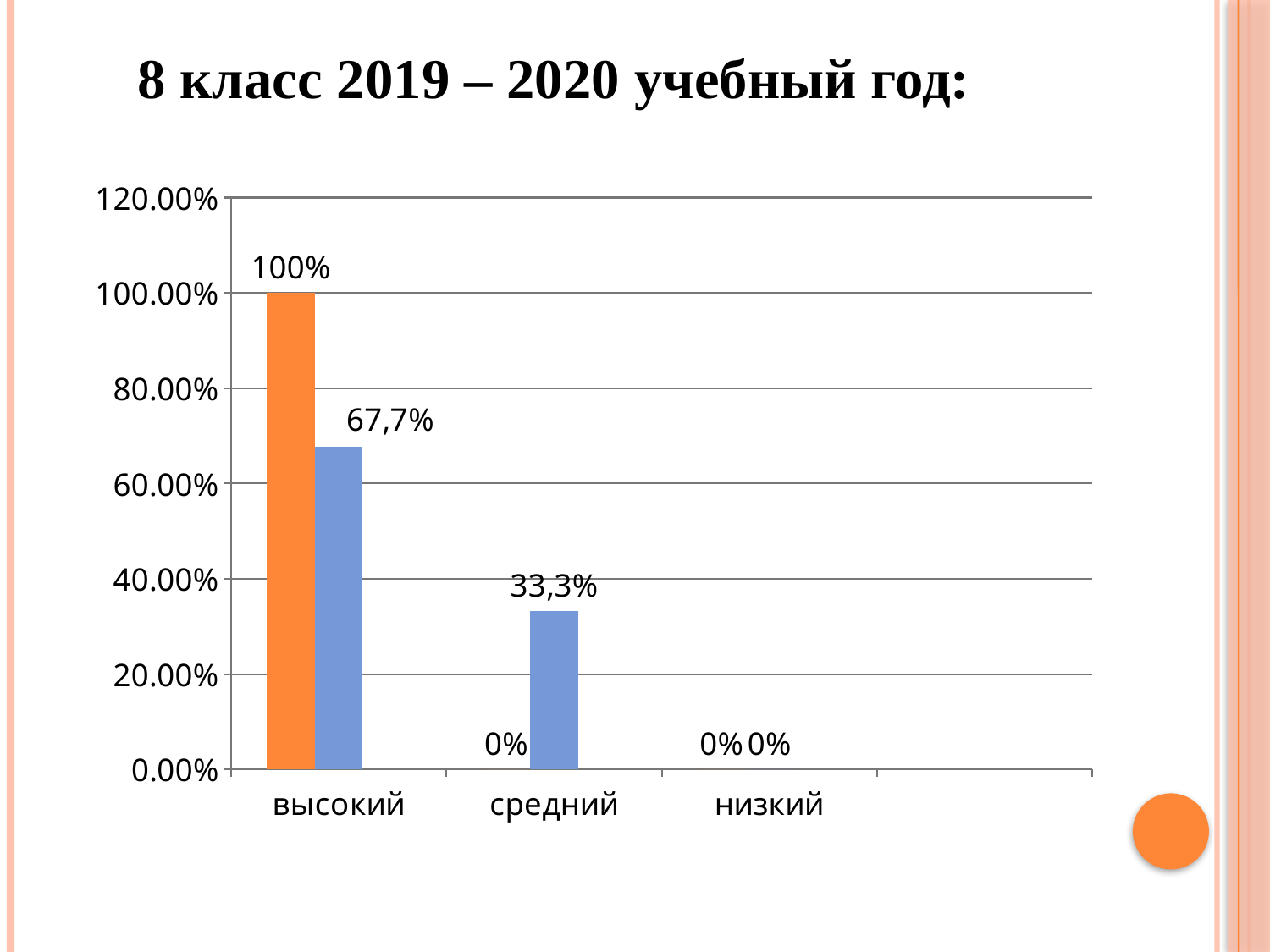
What is the value of the blue bar for средний? 33,3% Which category has the highest value in the chart? высокий What is the value of the orange bar for высокий? 100% Which category has the lowest blue bar? низкий What kind of chart is shown on the slide? bar chart What value is shown for низкий? 0% What is the difference between the blue bars for высокий and средний? 34,4% What is the difference between the orange and blue bars for высокий? 32,3% Which is larger: the blue bar for высокий or the blue bar for средний? высокий What is the value of the blue bar for высокий? 67,7% What is the value of the orange bar for средний? 0% What is the title of the slide above the chart? 8 класс 2019 – 2020 учебный год: